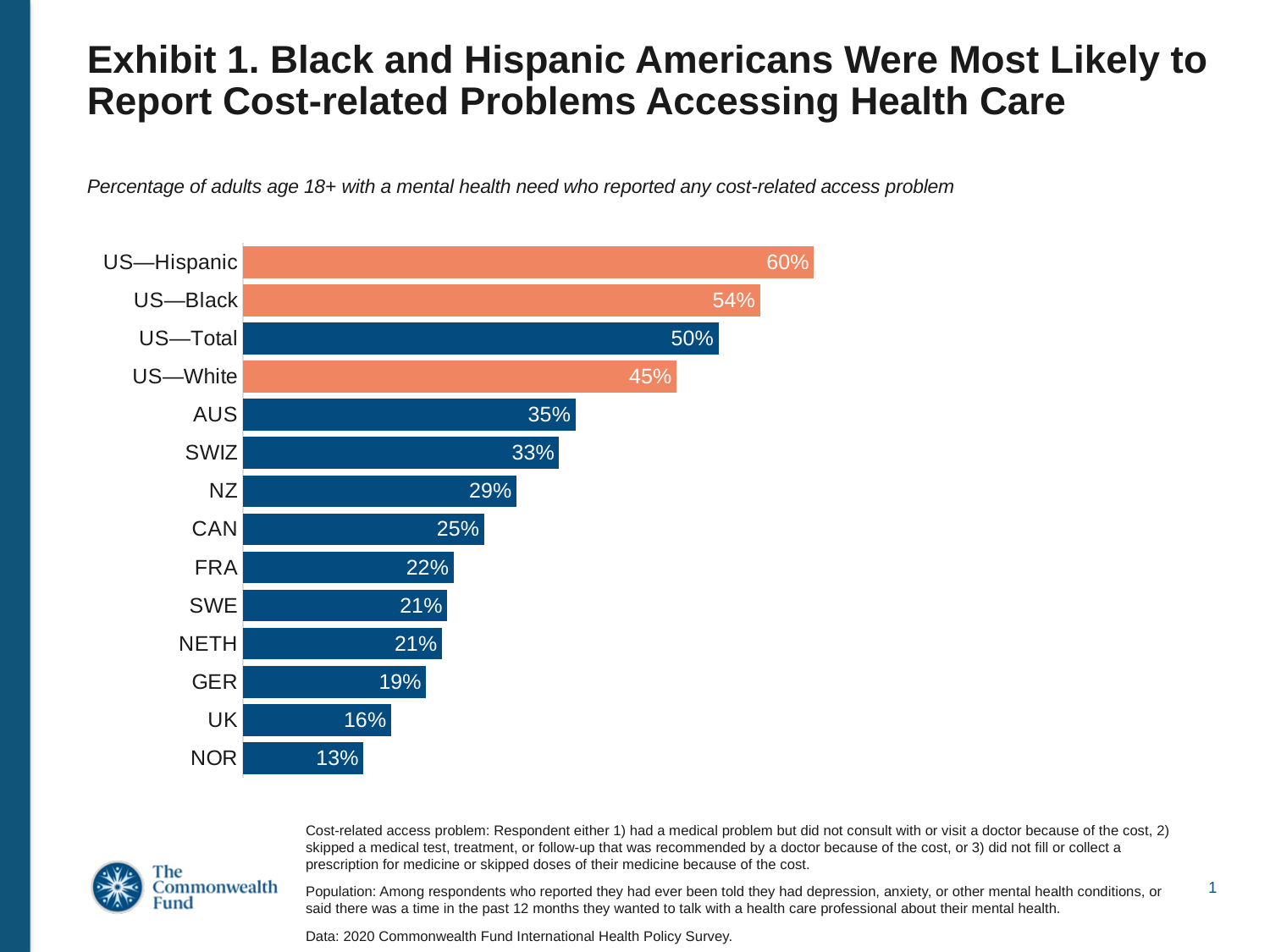
What kind of chart is shown on the slide? Bar chart How many categories are shown in the chart? 14 What is the value for SWIZ? 33% What is the difference between the values for US—Black and US—White? 9% Which category has the highest value? US—Hispanic What is the value for US—Hispanic? 60% Which categories are shown with orange bars? US—Hispanic, US—Black, US—White What is the difference between the values for AUS and UK? 19% What is the value for GER? 19% Which two categories share the same value of 21%? SWE and NETH Which is larger, the value for CAN or the value for FRA? CAN Which category has the lowest value? NOR